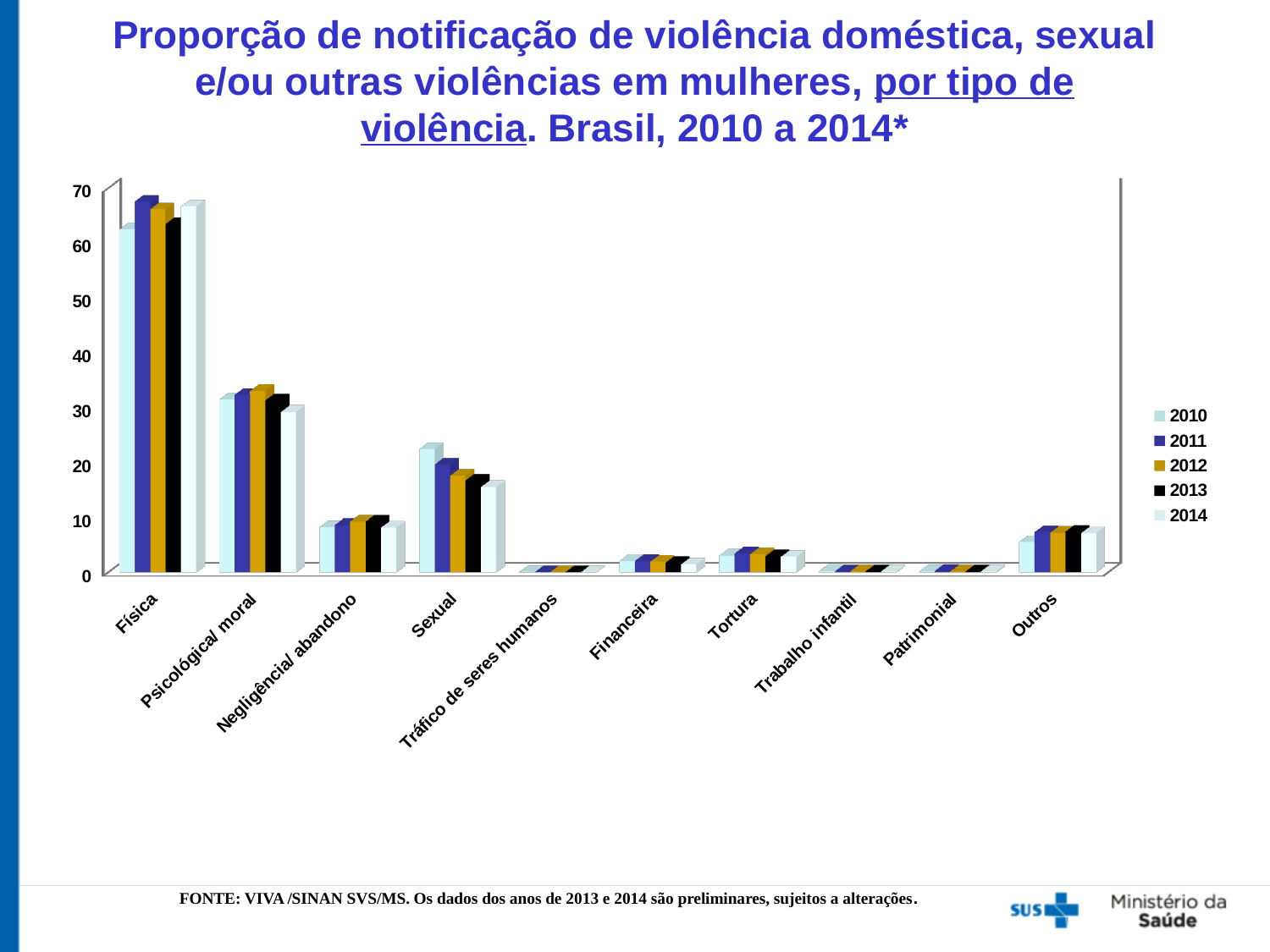
Is the value for Psicológica/moral in 2012 greater or less than 30? greater Is the value for Física in 2011 greater or less than 60? greater For 2012, which is larger: the value for Psicológica/moral or the value for Negligência/abandono? Psicológica/moral Is the value for Negligência/abandono in 2013 greater or less than 20? less How many types of violence (categories) are shown on the x axis? 10 What kind of chart is shown on the slide? bar chart For 2010, which is larger: the value for Física or the value for Sexual? Física How many series does the legend list? 5 Which type of violence has the highest proportion of notifications in every year? Física Which years are listed in the legend? 2010, 2011, 2012, 2013, 2014